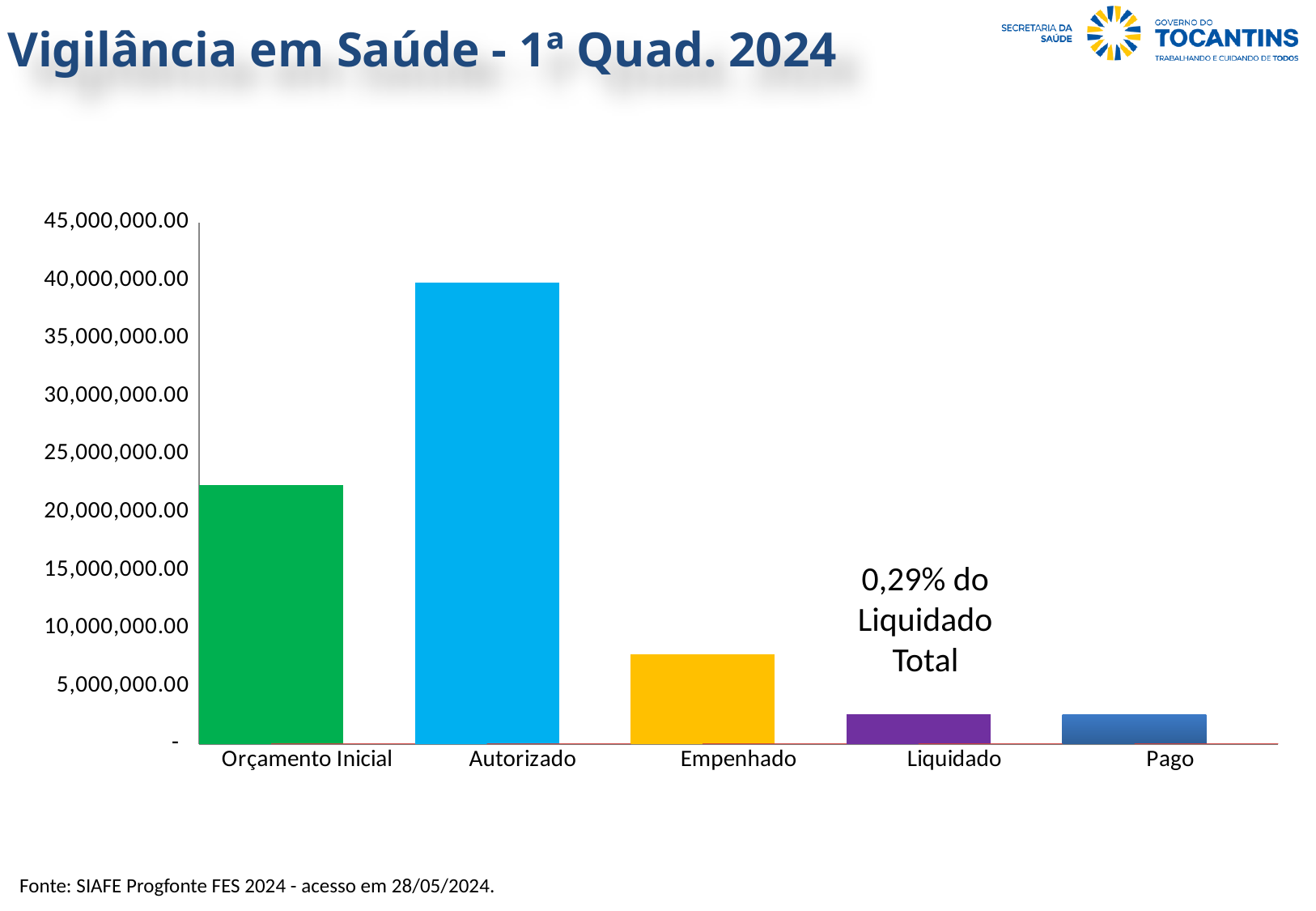
Is the value for Orçamento Inicial greater or less than 25,000,000.00? less Which is larger, the value for Orçamento Inicial or the value for Empenhado? Orçamento Inicial What text annotation appears above the Liquidado bar? 0,29% do Liquidado Total What kind of chart is shown on the slide? bar chart Is the value for Autorizado greater or less than 35,000,000.00? greater Is the value for Liquidado greater or less than 5,000,000.00? less What is the title of the slide containing the chart? Vigilância em Saúde - 1ª Quad. 2024 Which category has the highest value in the chart? Autorizado How many categories are shown on the x axis of the chart? 5 Which is larger, the value for Autorizado or the value for Orçamento Inicial? Autorizado